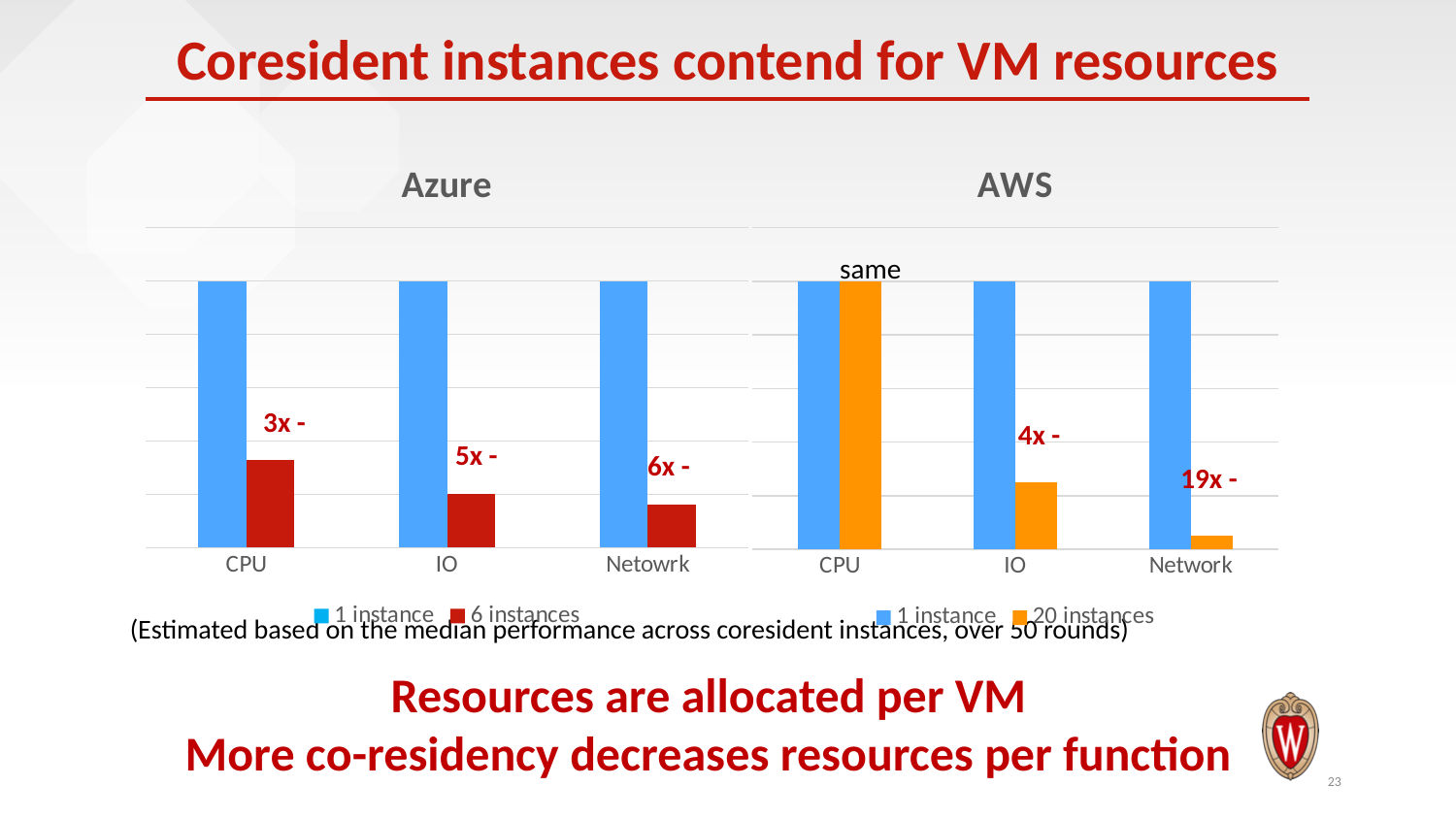
In the Azure chart, which is taller for IO: the 1 instance bar or the 6 instances bar? 1 instance In the Azure chart, what label is printed next to the 6 instances bar for IO? 5x - In the AWS chart, what label is printed next to the 20 instances bar for Network? 19x - In the Azure chart, which category has the lowest 6 instances bar? Netowrk In the AWS chart, which category has the highest 20 instances bar? CPU In the AWS chart, do the 20 instances bars rise or fall from CPU to Network? fall In the Azure chart, what label is printed next to the 6 instances bar for CPU? 3x - What are the two legend entries of the AWS chart? 1 instance, 20 instances What kind of chart is the Azure chart? bar chart How many categories are shown on the x axis of the AWS chart? 3 How many series does the legend of the Azure chart list? 2 In the AWS chart, what label is printed above the CPU bars? same